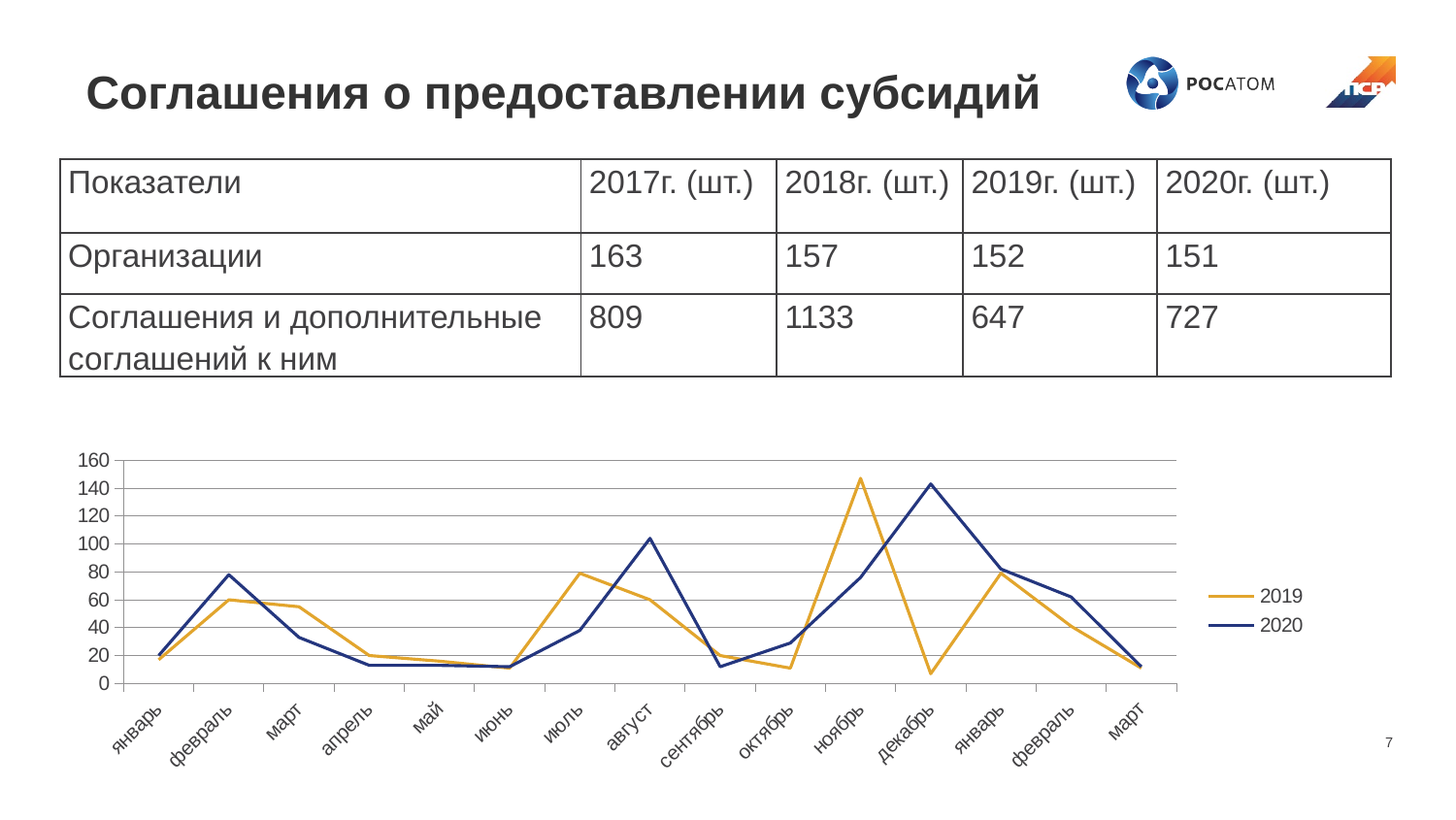
How many points (months) are plotted along the x axis of the chart? 15 In ноябрь, which series has the larger value, 2019 or 2020? 2019 In which month does the 2019 series reach its highest value? ноябрь In which month does the 2020 series reach its highest value? декабрь What kind of chart is shown on the slide? line chart In декабрь, which series has the larger value, 2019 or 2020? 2020 Is the value for 2019 in декабрь greater or less than 20? less Which series in the chart is drawn in dark blue? 2020 Is the value for 2019 in ноябрь greater or less than 140? greater How many series does the chart legend list? 2